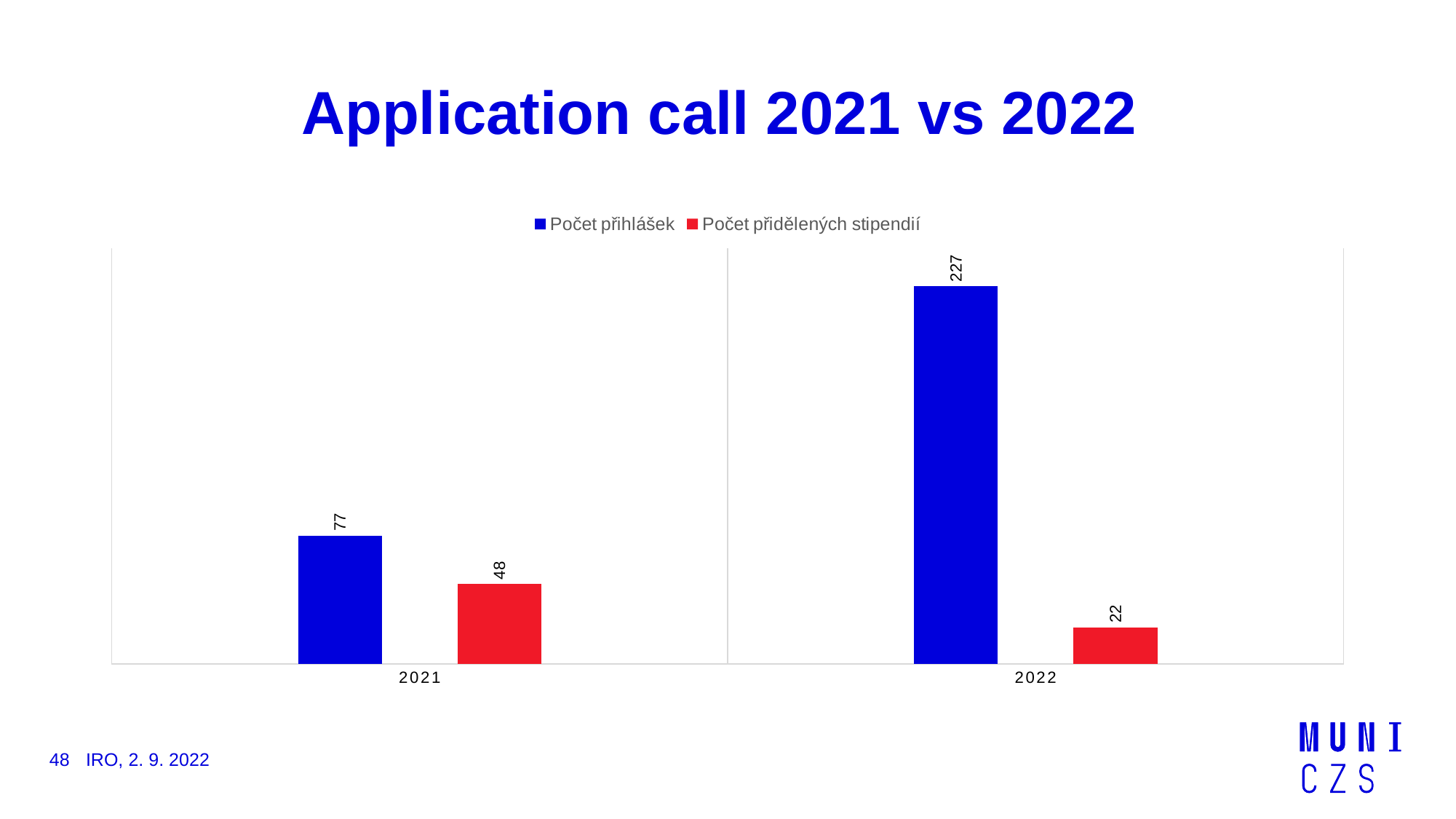
What kind of chart is shown on the slide? Bar chart Which year has the lower value for Počet přidělených stipendií? 2022 Which year has the higher value for Počet přihlášek? 2022 Is Počet přidělených stipendií larger in 2021 or in 2022? 2021 What is the difference between Počet přihlášek in 2022 and in 2021? 150 What is the difference between Počet přihlášek and Počet přidělených stipendií in 2021? 29 What is the value of Počet přidělených stipendií for 2022? 22 What colour represents Počet přidělených stipendií in the chart? Red How many series does the legend list? 2 What is the value of Počet přihlášek for 2021? 77 What is the value of Počet přihlášek for 2022? 227 What is the value of Počet přidělených stipendií for 2021? 48